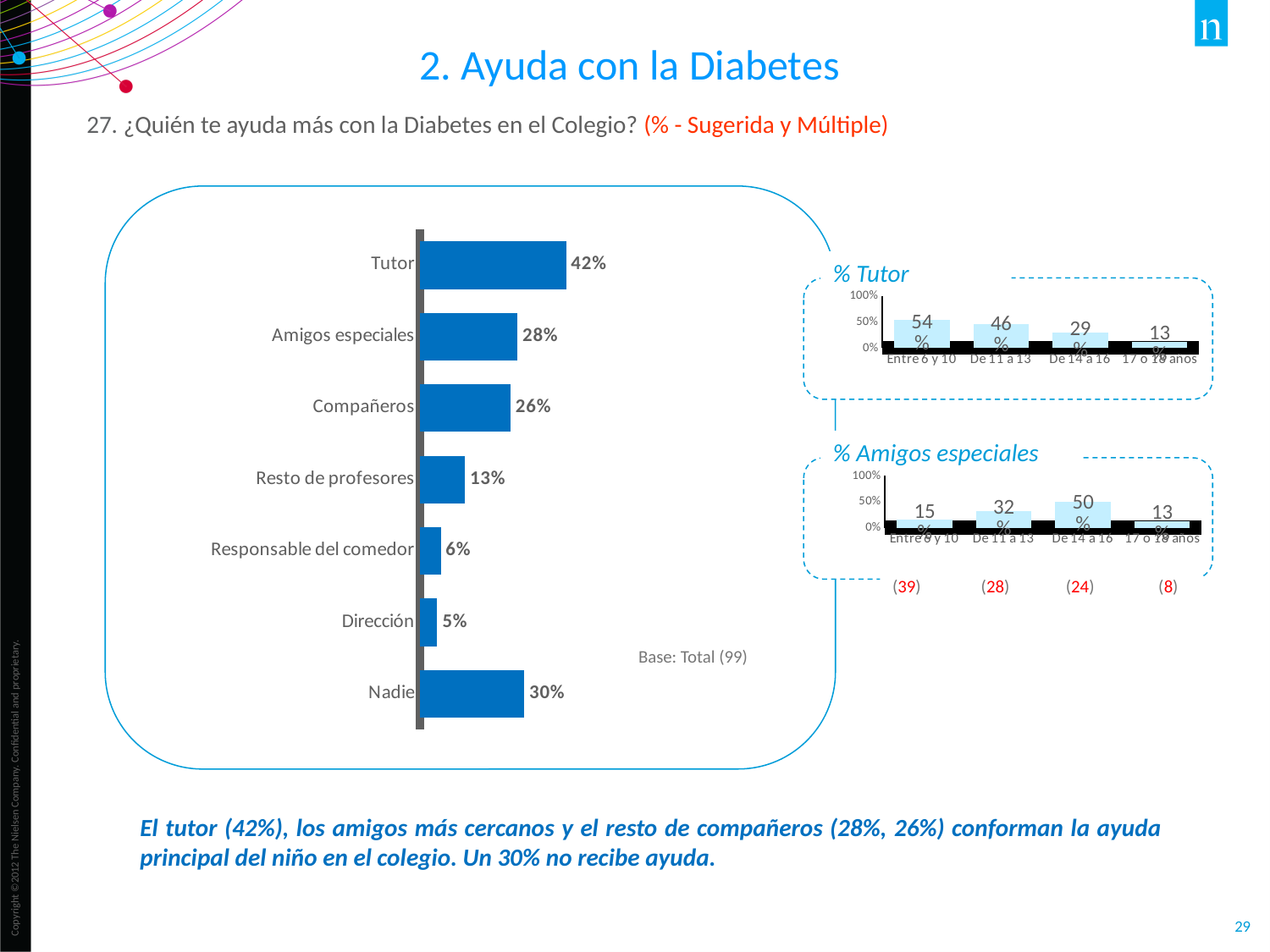
In the % Amigos especiales chart, what is the value for De 11 a 13? 32% In the % Tutor chart, do the values rise or fall across the age groups from left to right? Fall In the main bar chart, what is the difference between Tutor and Amigos especiales? 14% In the main bar chart, what is the value for Tutor? 42% What kind of chart is the main chart on the left? Bar chart In the main bar chart, which is larger, Compañeros or Resto de profesores? Compañeros In the main bar chart, which category has the highest value? Tutor How many categories does the main bar chart show? 7 In the main bar chart, which category has the lowest value? Dirección In the % Tutor chart, what is the value for Entre 6 y 10? 54% In the main bar chart, what is the value for Nadie? 30% In the % Amigos especiales chart, which age group has the highest value? De 14 a 16